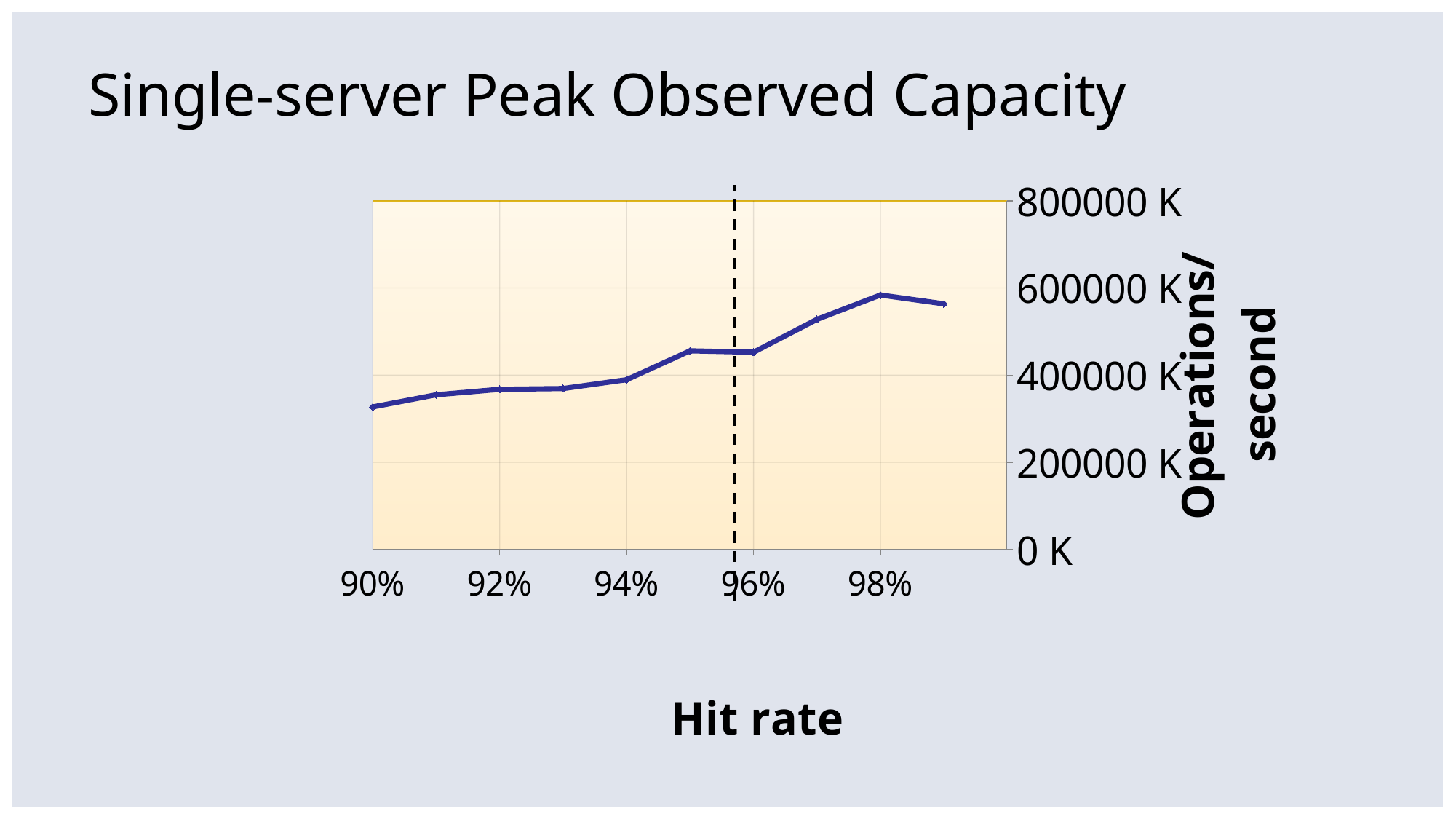
At which hit rate is the peak observed capacity highest? 98% Is the value at a 99% hit rate greater or less than 400000 K? greater Is the value at a 97% hit rate greater or less than 400000 K? greater What is the title of the chart? Single-server Peak Observed Capacity Is the value at a 90% hit rate greater or less than 400000 K? less At which hit rate is the peak observed capacity lowest? 90% How many data points are plotted on the line? 10 What kind of chart is shown on the slide? line chart What is the label of the x axis? Hit rate Does the capacity generally rise or fall as the hit rate increases from 90% to 98%? rise Which has the larger value: the 97% hit rate or the 92% hit rate? 97%